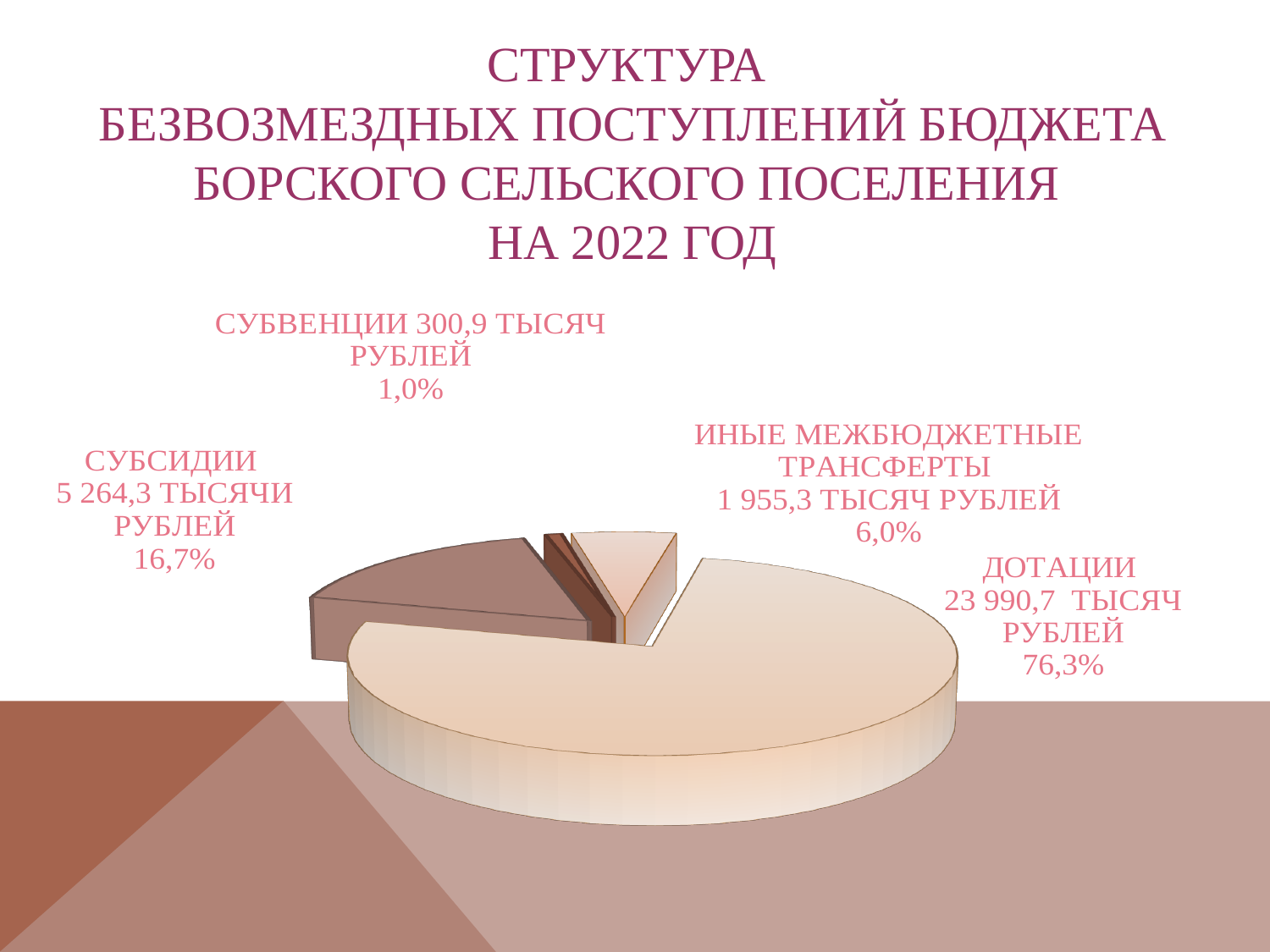
How many slices does the pie chart have? 4 What is the value for ДОТАЦИИ in the pie chart? 23 990,7 тысяч рублей What is the value for ИНЫЕ МЕЖБЮДЖЕТНЫЕ ТРАНСФЕРТЫ in the pie chart? 1 955,3 тысяч рублей Which is larger, СУБСИДИИ or ИНЫЕ МЕЖБЮДЖЕТНЫЕ ТРАНСФЕРТЫ? СУБСИДИИ What is the difference in thousands of rubles between ДОТАЦИИ and СУБСИДИИ? 18 726,4 What is the value for СУБВЕНЦИИ in the pie chart? 300,9 тысяч рублей What is the value for СУБСИДИИ in the pie chart? 5 264,3 тысячи рублей Which category has the smallest slice of the pie chart? СУБВЕНЦИИ What share of the pie does ДОТАЦИИ represent? 76,3% What share of the pie does СУБСИДИИ represent? 16,7% Which category has the largest slice of the pie chart? ДОТАЦИИ What kind of chart is shown on the slide? pie chart